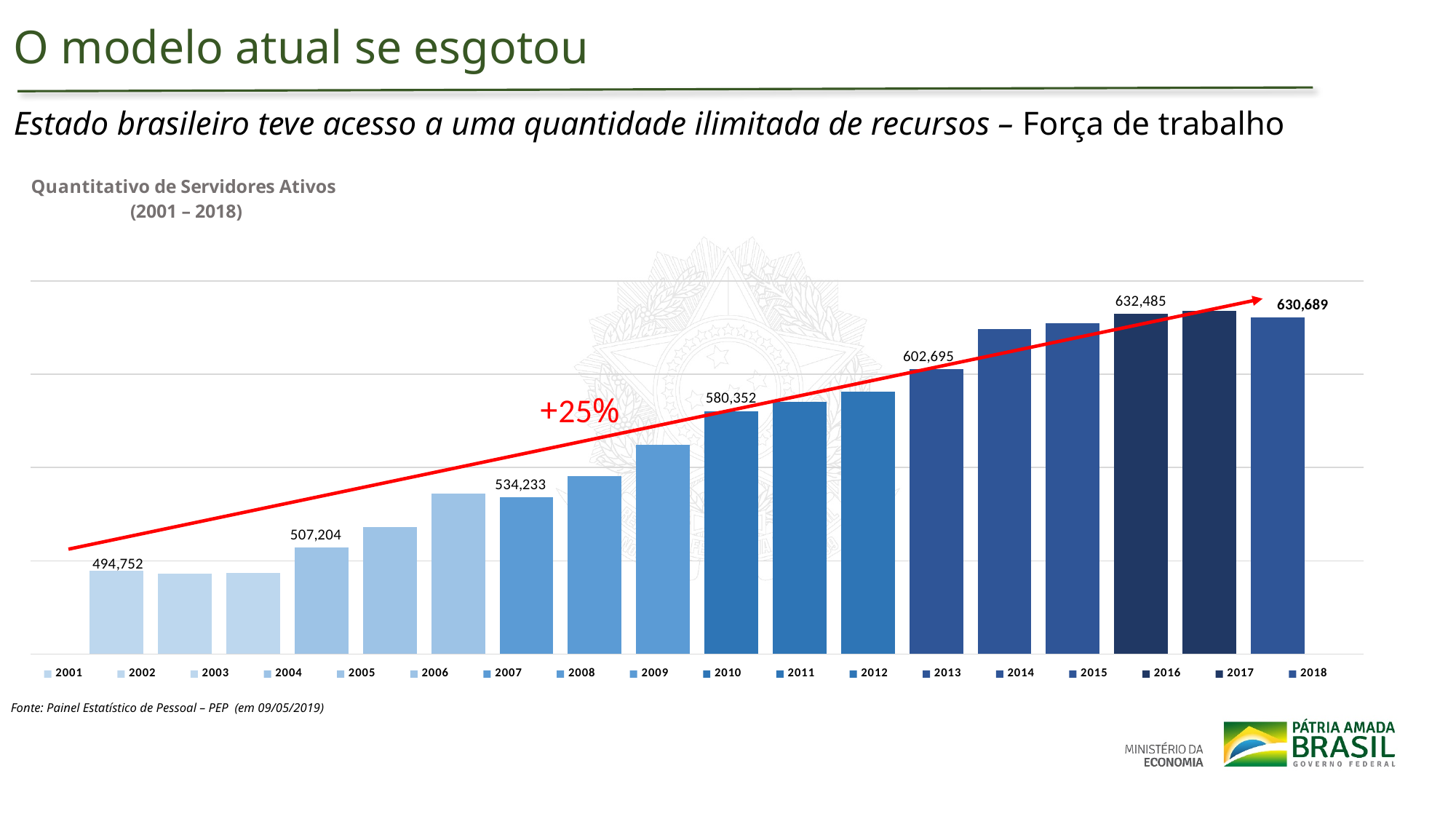
What is the title of the chart? Quantitativo de Servidores Ativos (2001 – 2018) Which is larger, the value for 2018 or the value for 2001? 2018 What is the difference between the values for 2016 and 2001? 137,733 What is the value for 2001 in the chart? 494,752 What is the value for 2013 in the chart? 602,695 What is the value for 2018 in the chart? 630,689 What kind of chart is shown on the slide? Bar chart How many years are plotted in the chart? 18 Do the values generally rise or fall from 2001 to 2018? Rise What is the value for 2010 in the chart? 580,352 What is the difference between the values for 2010 and 2007? 46,119 What is the value for 2016 in the chart? 632,485